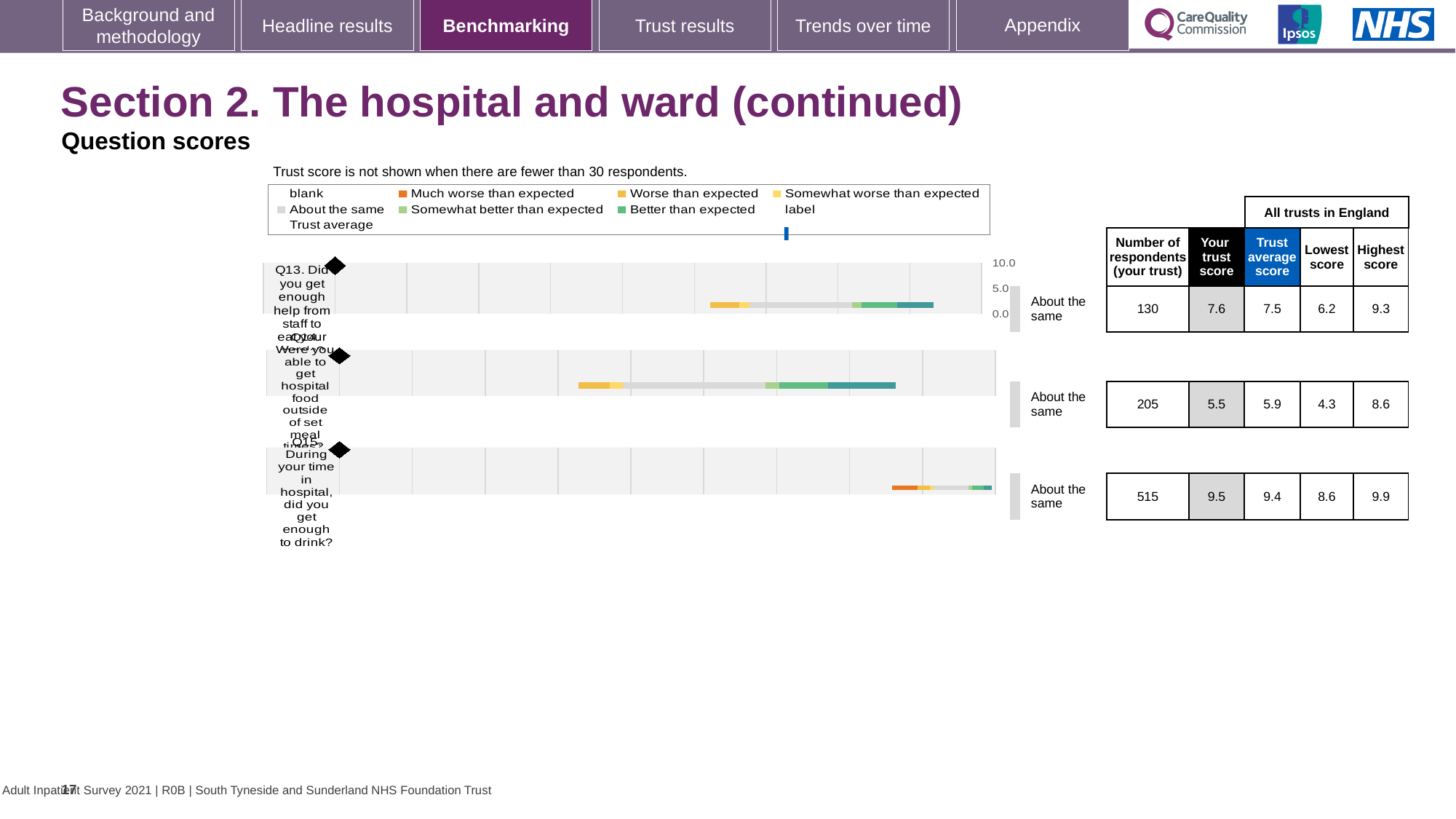
For Q14, which is larger: the 'Your trust score' or the 'Trust average score'? Trust average score What benchmark category is shown next to the Q13 chart? About the same What is the 'Your trust score' value for Q13? 7.6 Which question has the highest 'Your trust score'? Q15 What is the difference between the highest score and the lowest score for Q15? 1.3 How many questions (Q13, Q14, Q15) are plotted on the slide? 3 What is the difference between the 'Your trust score' and the 'Trust average score' for Q13? 0.1 Which question has the lowest 'Your trust score'? Q14 What is the number of respondents for Q15? 515 What kind of chart is used to show the question scores on this slide? bar chart What is the 'Highest score' across all trusts in England for Q14? 8.6 Which legend entry is shown in orange? Much worse than expected